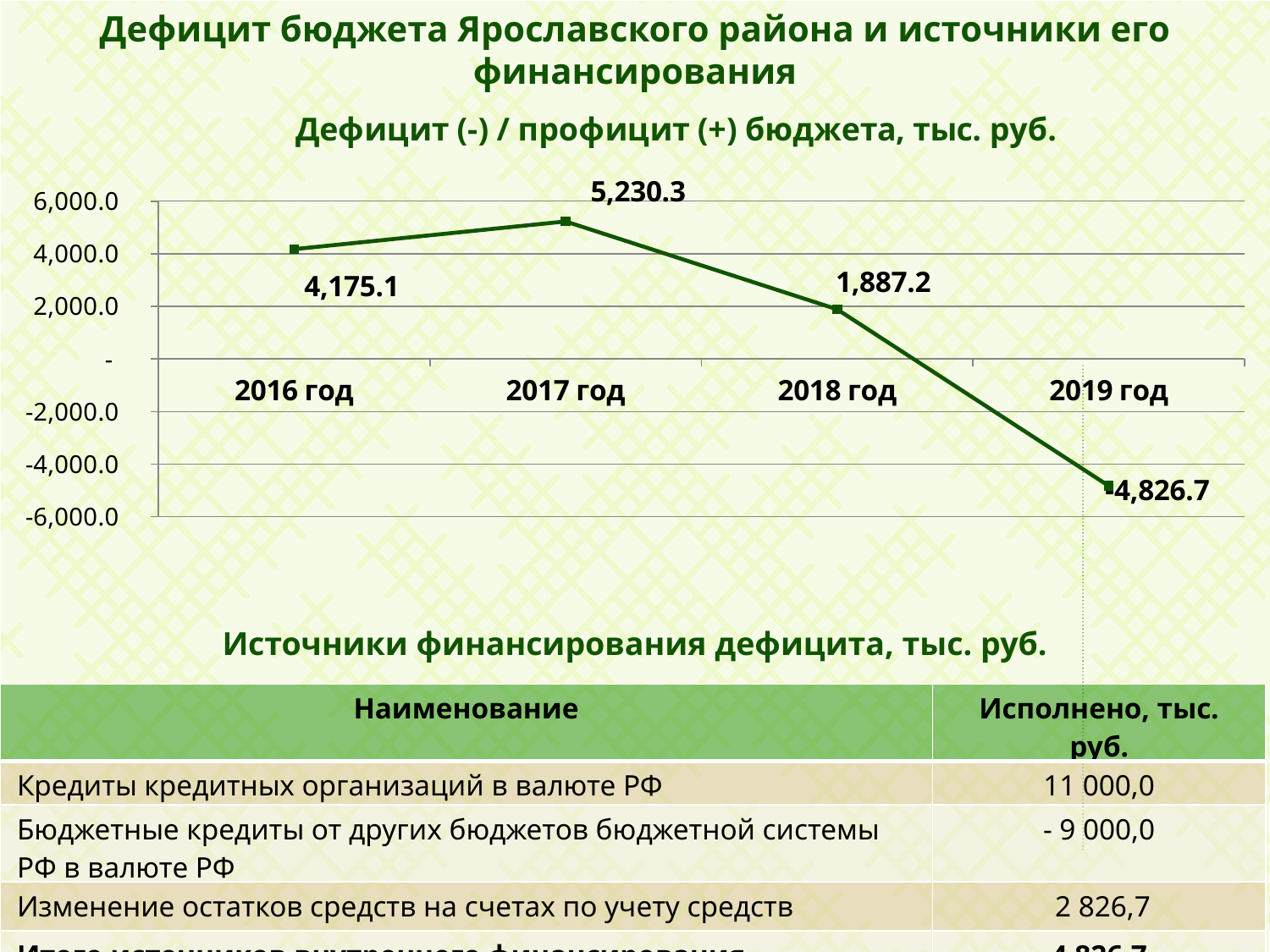
What is the value for 2019 год in the chart? -4,826.7 How many years are plotted in the chart? 4 What is the value for 2017 год in the chart? 5,230.3 Is the value for 2018 год greater or less than 2,000.0? less What is the difference between the values for 2017 год and 2018 год? 3,343.1 Which is larger, the value for 2016 год or the value for 2018 год? 2016 год Which year has the highest value in the chart? 2017 год What is the value for 2016 год in the chart? 4,175.1 Which year has the lowest value in the chart? 2019 год What kind of chart is shown on the slide? line chart What is the difference between the values for 2017 год and 2016 год? 1,055.2 Do the values rise or fall from 2017 год to 2019 год? fall